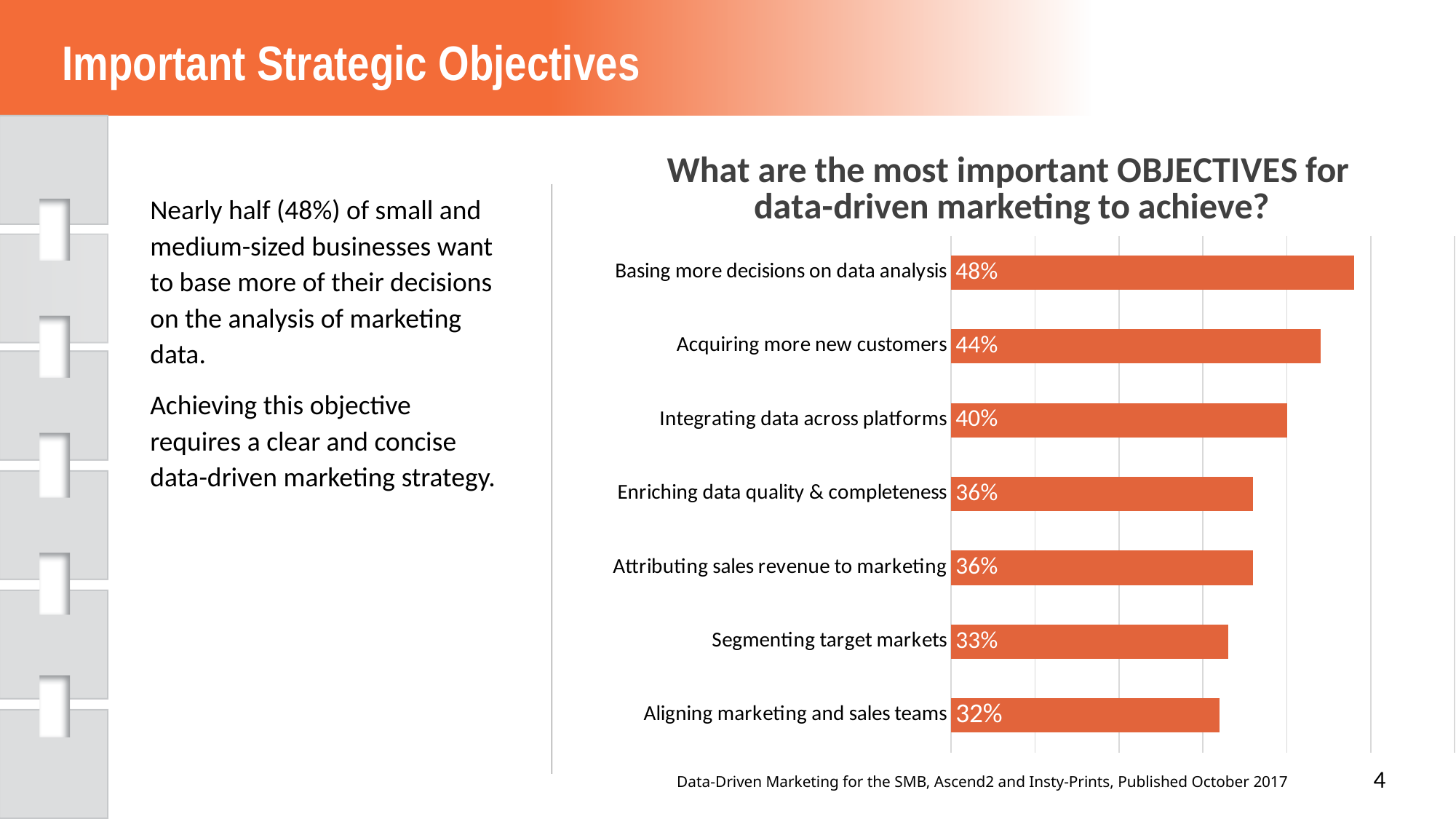
What is the title of the chart? What are the most important OBJECTIVES for data-driven marketing to achieve? Which objective has the highest percentage? Basing more decisions on data analysis What is the difference between "Integrating data across platforms" and "Segmenting target markets"? 7% Which two objectives share the same value of 36%? Enriching data quality & completeness; Attributing sales revenue to marketing What is the value for "Aligning marketing and sales teams"? 32% What kind of chart is shown on the slide? Bar chart How many objectives are listed in the chart? 7 What is the value for "Integrating data across platforms"? 40% What is the difference between "Basing more decisions on data analysis" and "Acquiring more new customers"? 4% Which is larger: "Acquiring more new customers" or "Enriching data quality & completeness"? Acquiring more new customers Which objective has the lowest percentage? Aligning marketing and sales teams What percentage is shown for "Basing more decisions on data analysis"? 48%